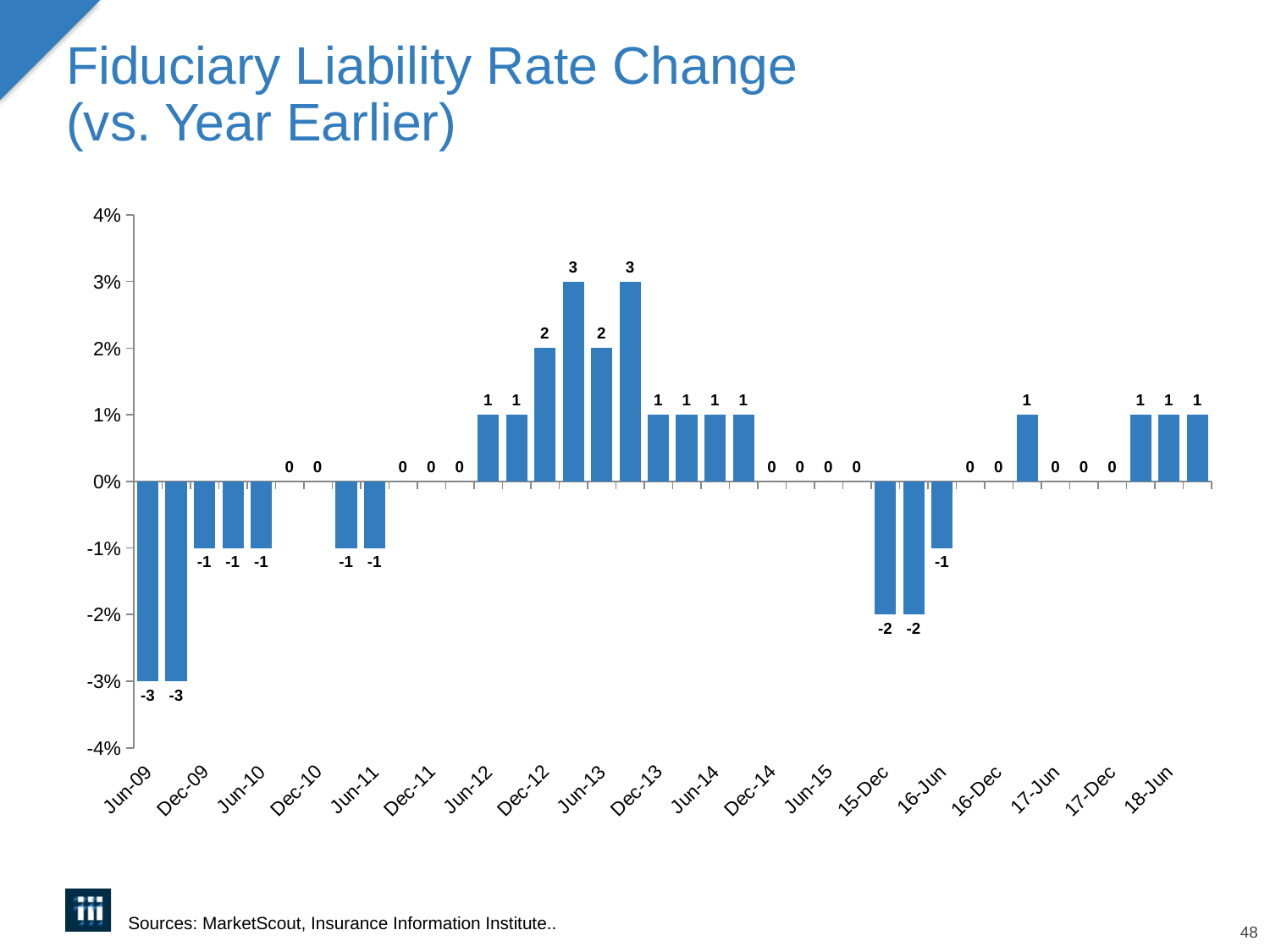
What is the value for 16-Jun? -1 Which is larger, the value for Jun-09 or the value for 15-Dec? 15-Dec What is the value for Jun-09? -3 What is the highest value shown by any bar in the chart? 3 What is the title of the chart on the slide? Fiduciary Liability Rate Change (vs. Year Earlier) What is the value for 15-Dec? -2 How many bars in the chart reach a value of 3? 2 What kind of chart is shown on the slide? Bar chart What is the difference between the highest bar value and the lowest bar value in the chart? 6 Do the values generally rise or fall from Jun-09 to Dec-12? Rise What is the lowest value shown by any bar in the chart? -3 What is the value for Dec-12? 2